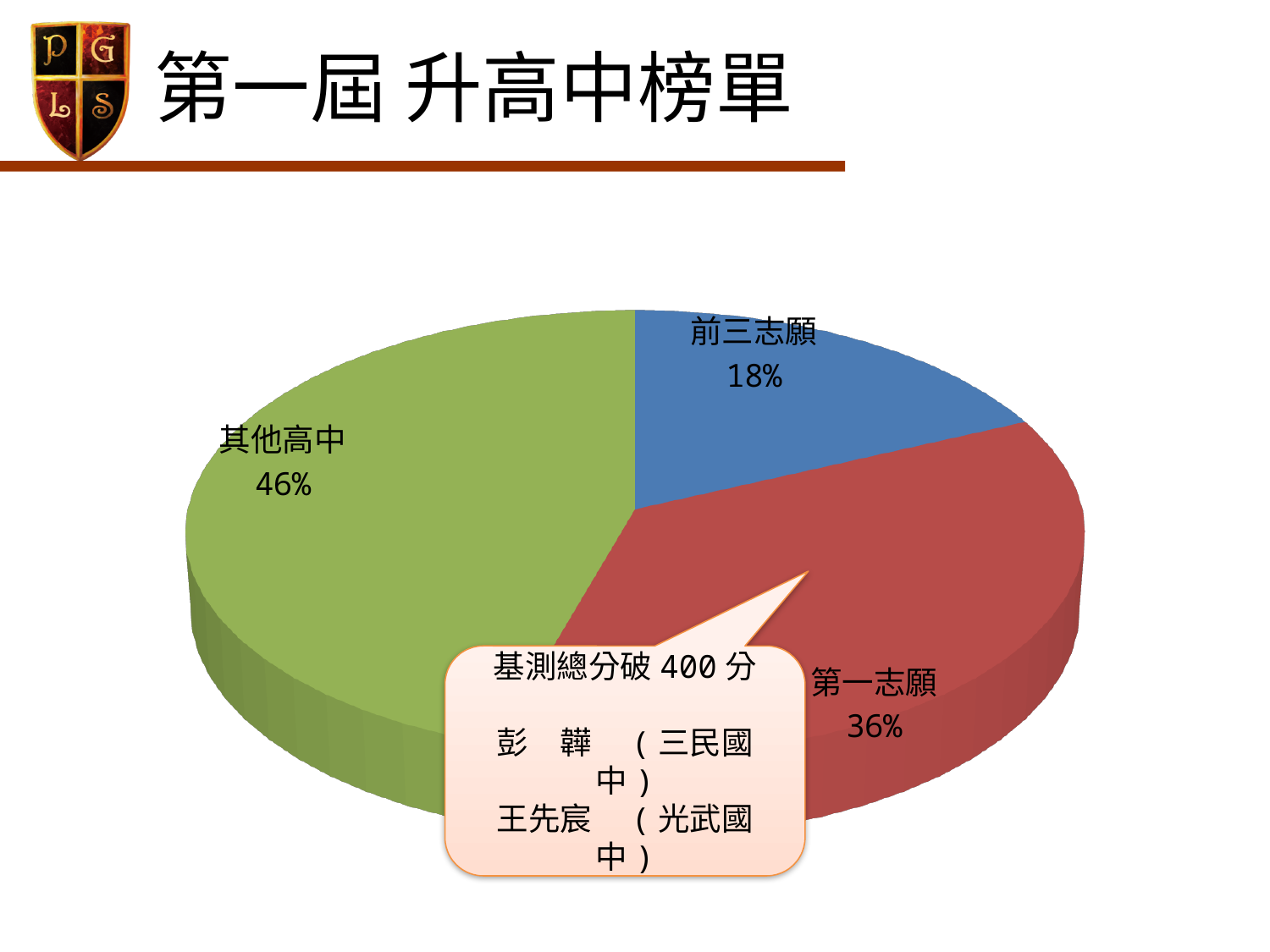
What is the difference in percentage points between 其他高中 and 第一志願? 10 What share of the pie does 其他高中 represent? 46% Which slice of the pie chart is the smallest? 前三志願 What kind of chart is shown on the slide? pie chart Which is larger, the share for 第一志願 or the share for 前三志願? 第一志願 Which slice of the pie chart is the largest? 其他高中 What share of the pie does 前三志願 represent? 18% What colour is the 其他高中 slice of the pie chart? green What share of the pie does 第一志願 represent? 36% What is the difference in percentage points between 第一志願 and 前三志願? 18 How many slices does the pie chart have? 3 What colour is the 前三志願 slice of the pie chart? blue